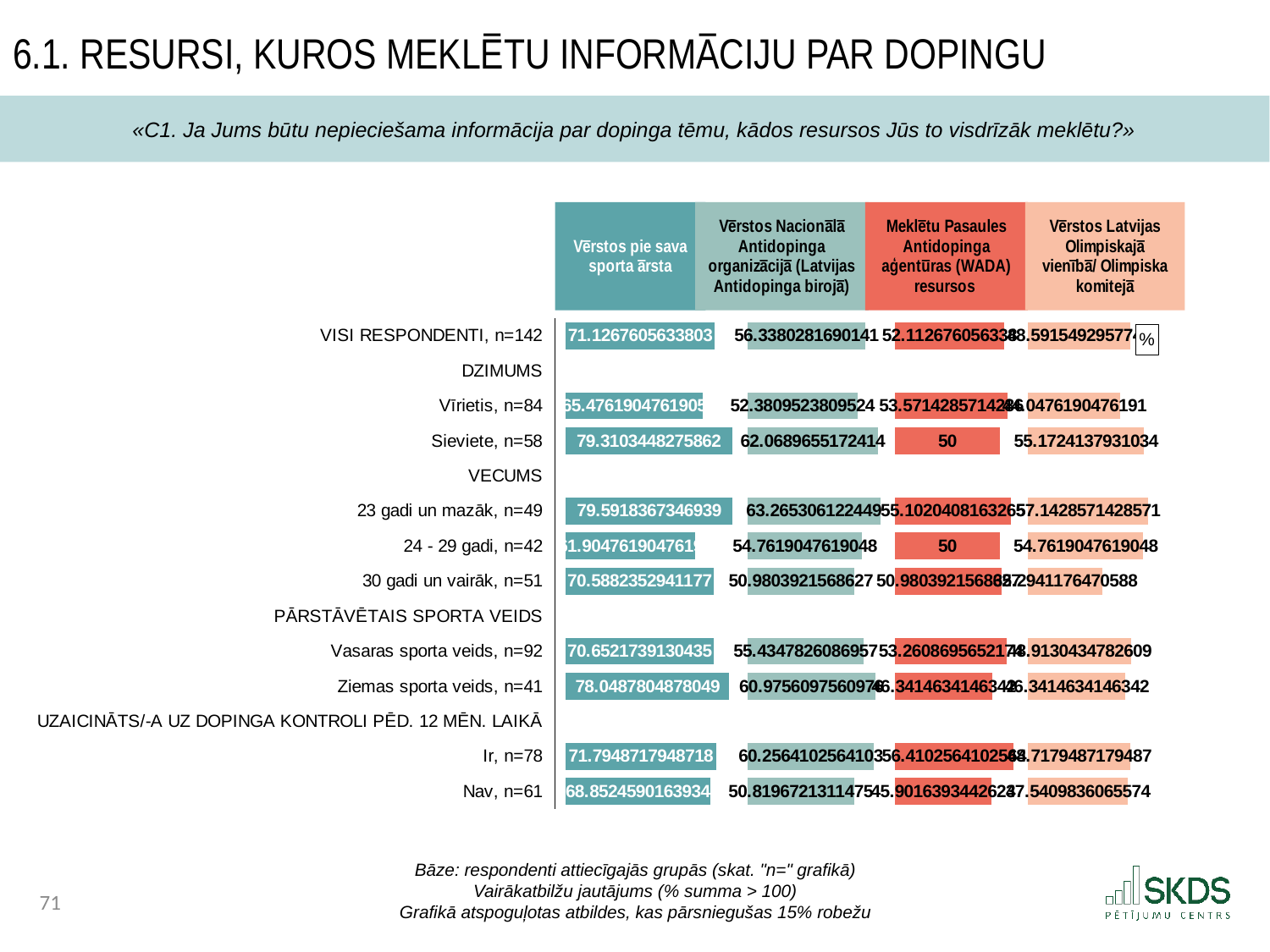
What is the value for Ir, n=78 in the series Vērstos Nacionālā Antidopinga organizācijā (Latvijas Antidopinga birojā)? 60.2564102564103 Which series is shown in red? Meklētu Pasaules Antidopinga aģentūras (WADA) resursos What is the value for Ziemas sporta veids, n=41 in the series Vērstos pie sava sporta ārsta? 78.0487804878049 What is the value for Sieviete, n=58 in the series Meklētu Pasaules Antidopinga aģentūras (WADA) resursos? 50 For Sieviete, n=58, what is the difference between Vērstos Nacionālā Antidopinga organizācijā and Meklētu Pasaules Antidopinga aģentūras (WADA) resursos? 12.0689655172414 How many series does the chart show? 4 What is the value for Nav, n=61 in the series Vērstos pie sava sporta ārsta? 68.8524590163934 For Sieviete, n=58, which is larger: Vērstos Nacionālā Antidopinga organizācijā or Vērstos Latvijas Olimpiskajā vienībā/ Olimpiskajā komitejā? Vērstos Nacionālā Antidopinga organizācijā What kind of chart is shown on the slide? bar chart What is the value for Sieviete, n=58 in the series Vērstos pie sava sporta ārsta? 79.3103448275862 What is the value for 24 - 29 gadi, n=42 in the series Vērstos Latvijas Olimpiskajā vienībā/ Olimpiskajā komitejā? 54.7619047619048 In the series Vērstos pie sava sporta ārsta, which is larger: Vīrietis, n=84 or Sieviete, n=58? Sieviete, n=58